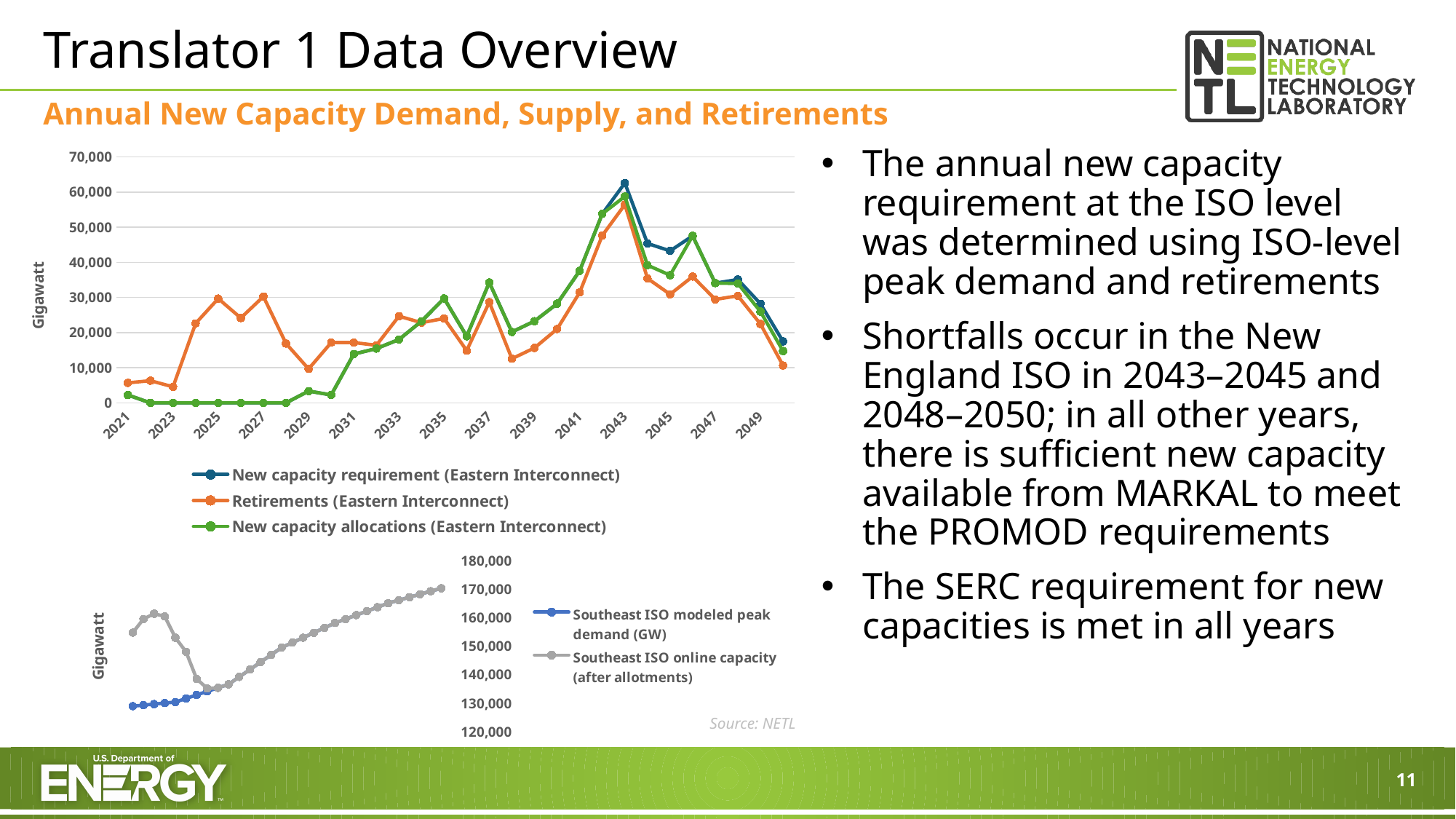
In the top chart, is the value for New capacity requirement (Eastern Interconnect) in 2043 greater or less than 60,000? greater In the top chart, in 2047, which is larger: New capacity requirement (Eastern Interconnect) or Retirements (Eastern Interconnect)? New capacity requirement (Eastern Interconnect) What kind of chart is the top chart on the slide? Line chart What kind of chart is the bottom chart on the slide? Line chart How many series does the legend of the bottom chart list? 2 How many series does the legend of the top chart list? 3 In the top chart, is the value for Retirements (Eastern Interconnect) in 2021 greater or less than 10,000? less In the top chart, is the value for New capacity allocations (Eastern Interconnect) in 2023 greater or less than 10,000? less What is the y-axis label of the top chart? Gigawatt In the top chart, in 2025, which is larger: Retirements (Eastern Interconnect) or New capacity allocations (Eastern Interconnect)? Retirements (Eastern Interconnect) In the top chart, in which year does the New capacity requirement (Eastern Interconnect) reach its highest value? 2043